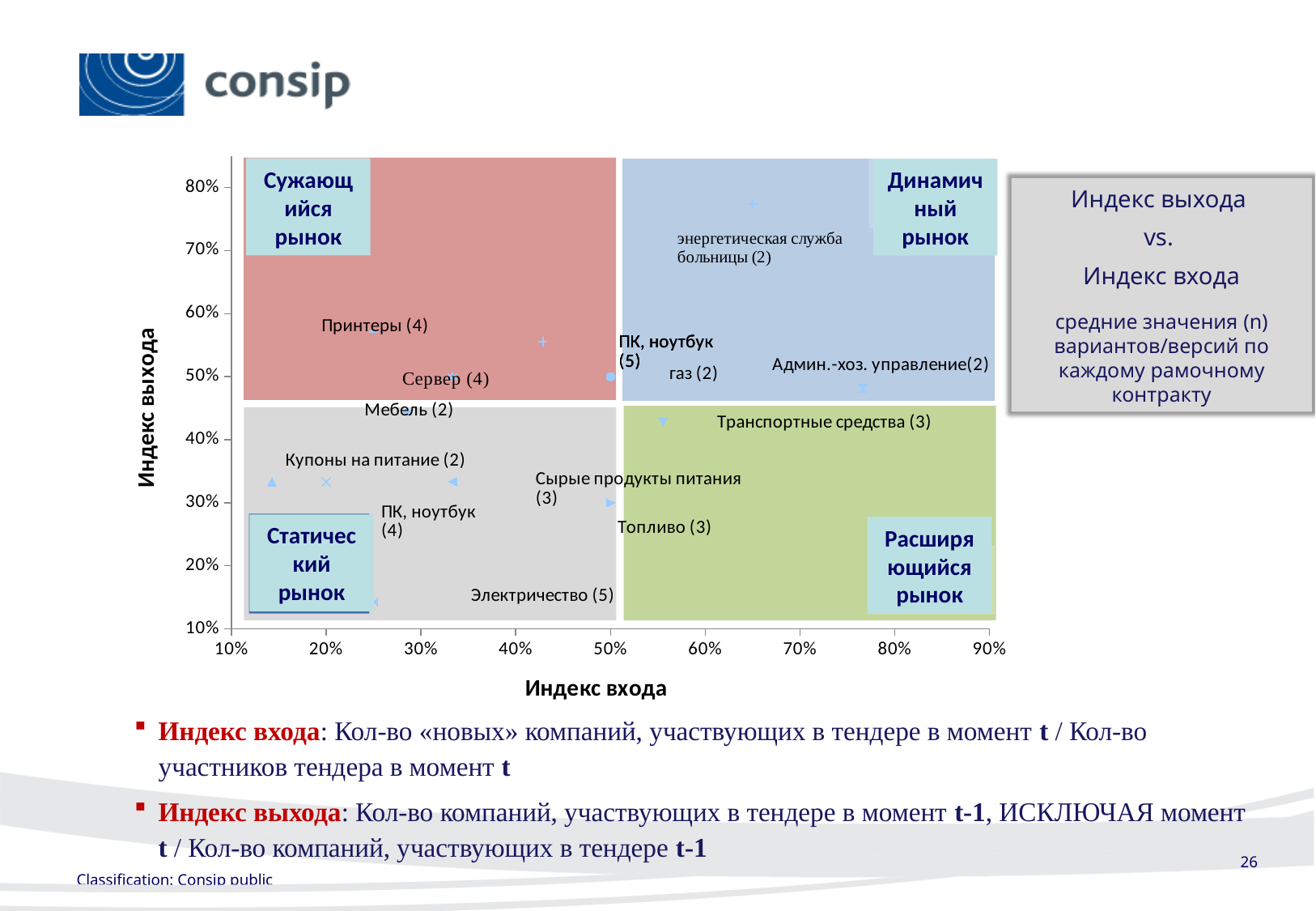
Is the Индекс выхода value for Транспортные средства (3) greater or less than 50%? less Is the Индекс входа value for Транспортные средства (3) greater or less than 50%? greater What is the title of the vertical axis of the chart? Индекс выхода Is the Индекс выхода value for Купоны на питание (2) greater or less than 40%? less What kind of chart is shown on the slide? scatter chart Which market type label is placed in the top-right quadrant of the chart? Динамичный рынок Which has the higher Индекс входа: Админ.-хоз. управление(2) or Принтеры (4)? Админ.-хоз. управление(2) Which has the higher Индекс выхода: энергетическая служба больницы (2) or Купоны на питание (2)? энергетическая служба больницы (2)